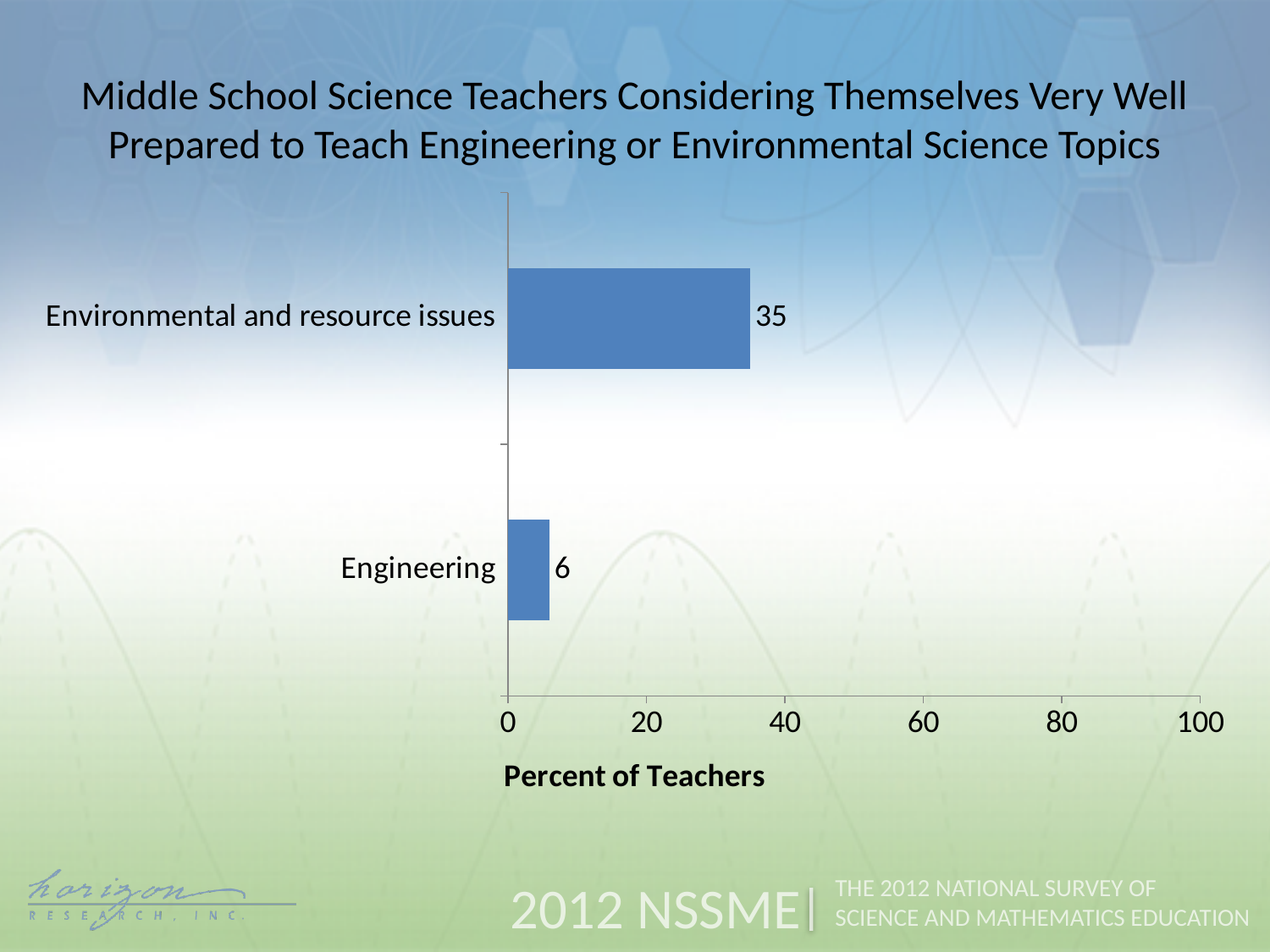
What is the maximum value shown on the horizontal axis? 100 What is the difference between the values for Environmental and resource issues and Engineering? 29 Which is larger, the value for Engineering or the value for Environmental and resource issues? Environmental and resource issues What percent of teachers is shown for Environmental and resource issues? 35 How many categories are shown in the chart? 2 Is the value for Environmental and resource issues greater or less than 40? less What percent of teachers is shown for Engineering? 6 Which category has the highest value? Environmental and resource issues What kind of chart is shown on the slide? bar chart Is the value for Engineering greater or less than 20? less What is the label of the horizontal axis? Percent of Teachers Which category has the lowest value? Engineering